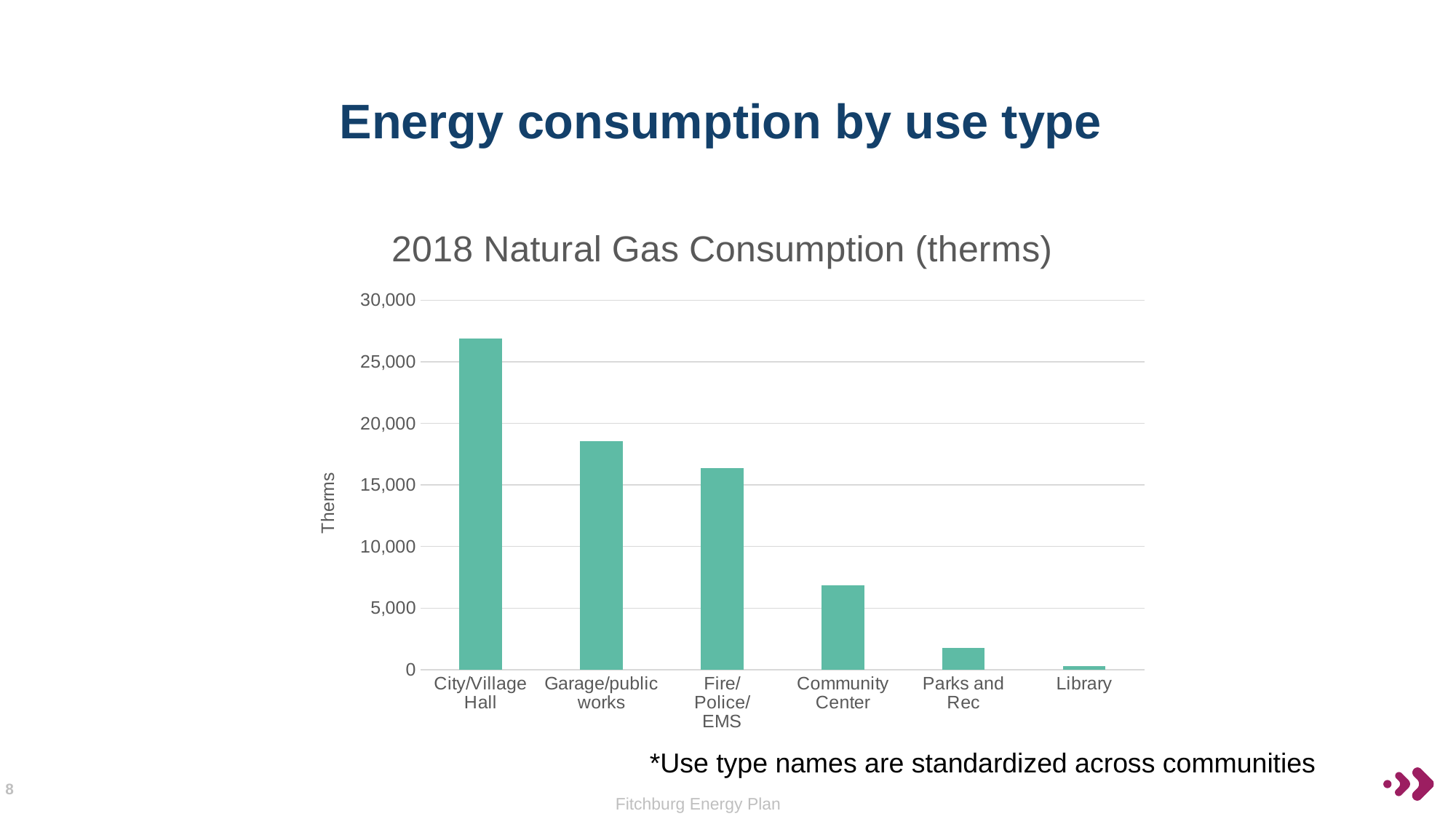
Is the value for City/Village Hall greater or less than 25,000? greater Is the value for Community Center greater or less than 5,000? greater How many use type categories are shown in the chart? 6 What is the label on the vertical axis of the chart? Therms What kind of chart is shown on the slide? bar chart Which use type has the highest natural gas consumption? City/Village Hall Do the values rise or fall moving from left to right across the categories? fall Is the value for Garage/public works greater or less than 20,000? less Which has higher natural gas consumption, Garage/public works or Fire/Police/EMS? Garage/public works Which use type has the lowest natural gas consumption? Library Which has higher natural gas consumption, Community Center or Parks and Rec? Community Center What is the title of the chart? 2018 Natural Gas Consumption (therms)